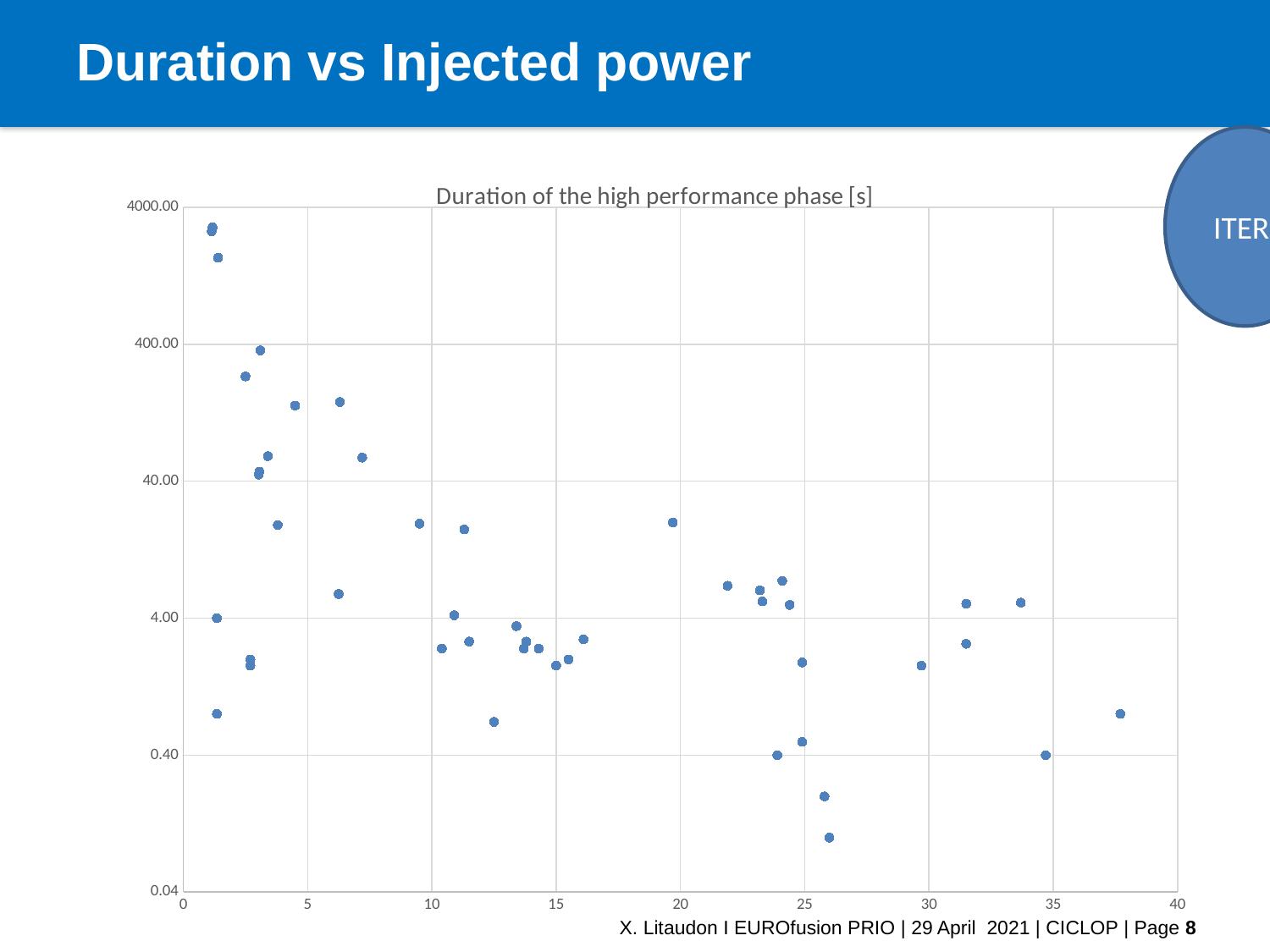
Is the value of the rightmost point on the chart greater or less than 4.00? less Do the plotted values generally rise or fall as the x value increases? fall What kind of chart is shown on the slide? scatter chart Is the value of the lowest point on the chart greater or less than 0.40? less Is the value of the rightmost point on the chart greater or less than 0.40? greater Are the points near x = 0 to 5 mostly above or below the points near x = 30 to 40? above What is the title of the chart? Duration of the high performance phase [s] What is the lowest value labelled on the y axis of the chart? 0.04 What is the highest value labelled on the y axis of the chart? 4000.00 What is the largest value labelled on the x axis of the chart? 40